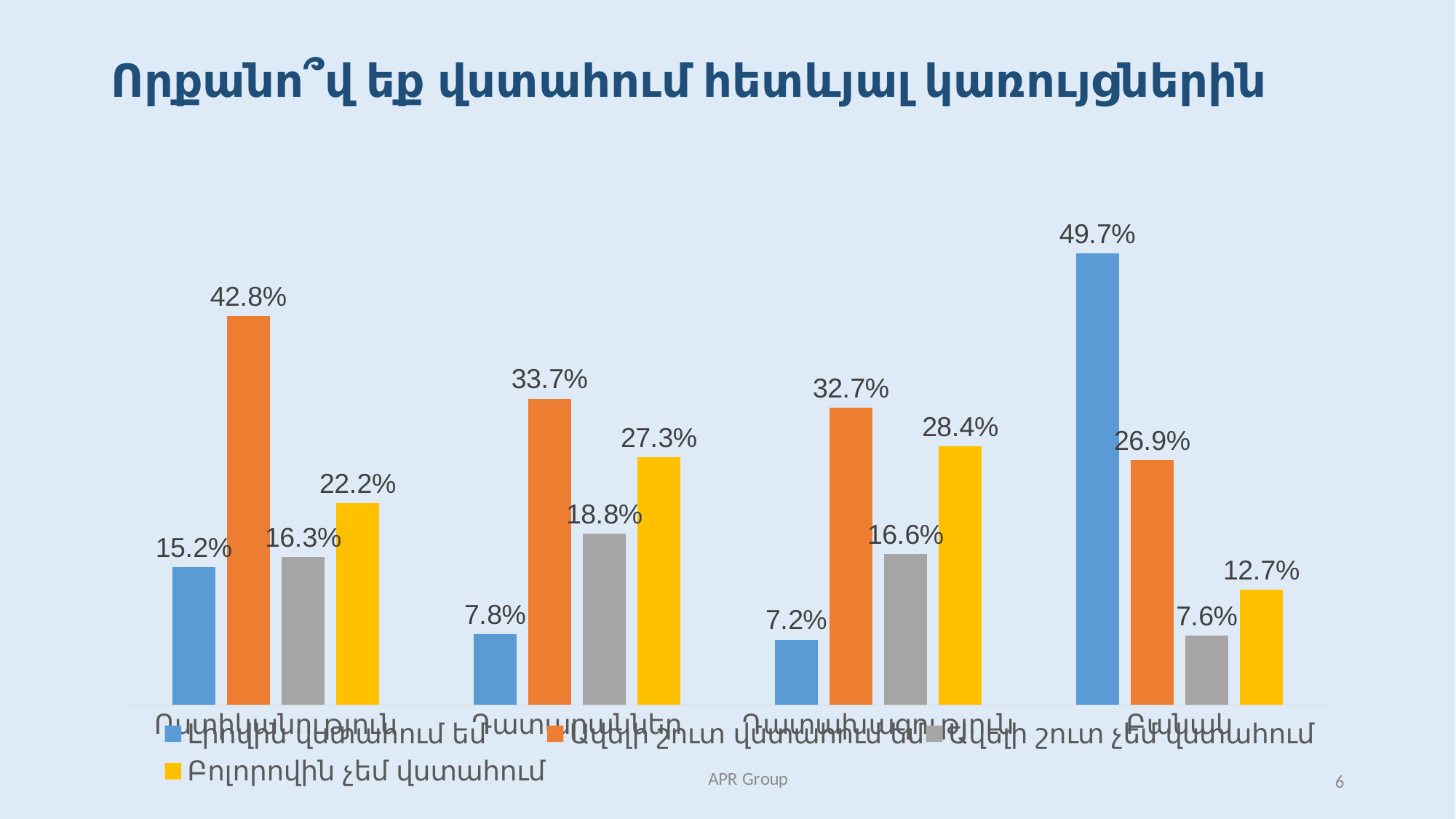
Which category has the highest value for the 'Լիովին վստահում եմ' (blue) series? Բանակ Which category has the lowest value for the 'Ավելի շուտ չեմ վստահում' (gray) series? Բանակ How many categories (institutions) are shown on the x axis? 4 What is the value of the 'Ավելի շուտ չեմ վստահում' (gray) series for Դատարաններ? 18.8% Which colour represents the 'Ավելի շուտ վստահում եմ' series in the legend? Orange How many series does the legend list? 4 What kind of chart is shown on the slide? Bar chart What is the value of the 'Ավելի շուտ վստահում եմ' (orange) series for Ոստիկանություն? 42.8% What is the value of the 'Բոլորովին չեմ վստահում' (yellow) series for Դատախազություն? 28.4% What is the difference between the 'Ավելի շուտ վստահում եմ' values for Ոստիկանություն and Բանակ? 15.9% What is the value of the 'Լիովին վստահում եմ' (blue) series for Բանակ? 49.7% Which is larger: the 'Բոլորովին չեմ վստահում' value for Դատարաններ or for Ոստիկանություն? Դատարաններ